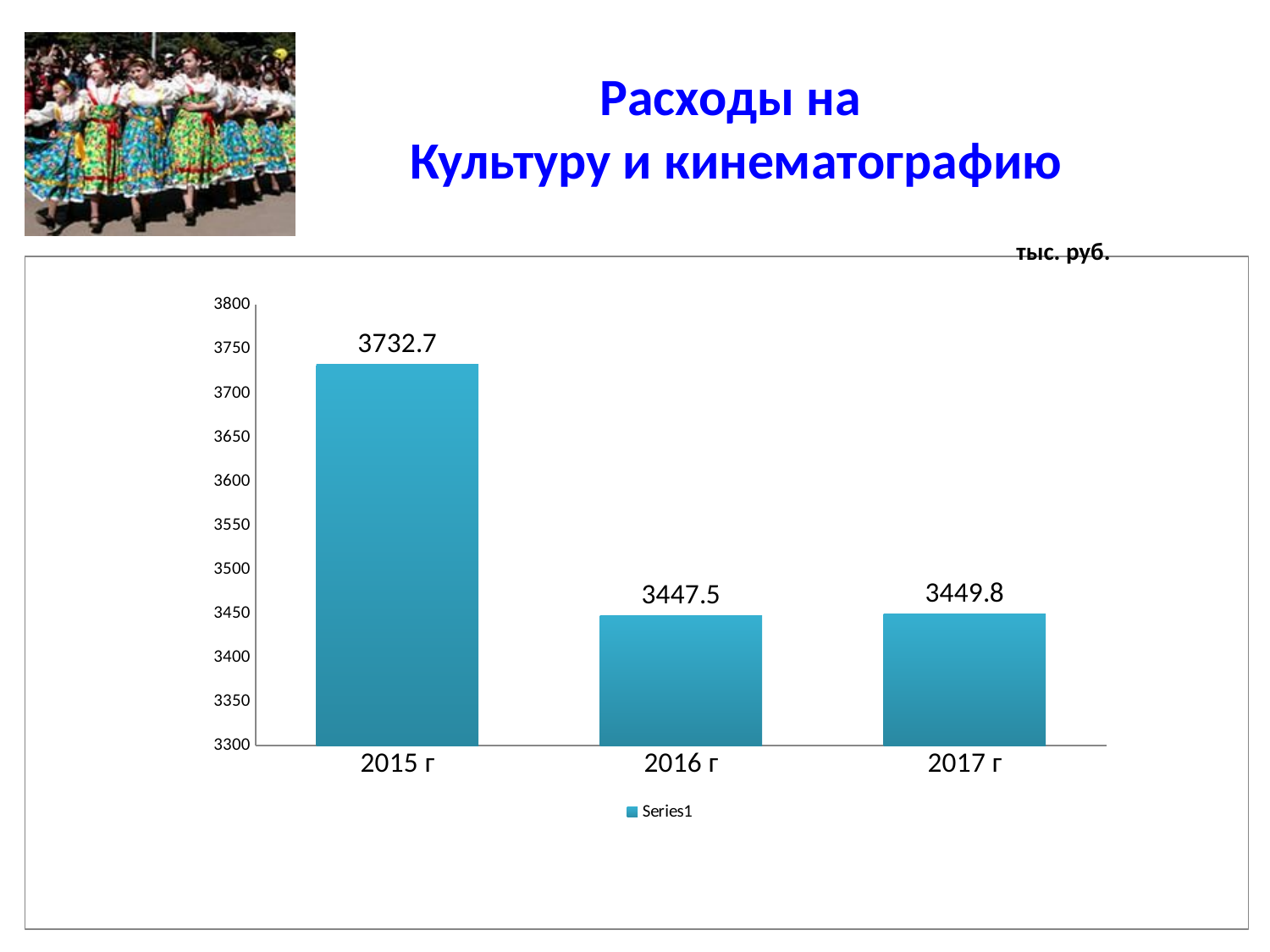
What kind of chart is shown on the slide? bar chart Which year has the lowest value? 2016 г What is the difference between the values for 2015 г and 2016 г? 285.2 What unit is indicated above the chart? тыс. руб. What is the value for 2016 г? 3447.5 How many years are shown on the x axis? 3 Is the value for 2015 г greater or less than 3700? greater Which year has the highest value? 2015 г What is the value for 2017 г? 3449.8 What is the value for 2015 г? 3732.7 Which is larger, the value for 2016 г or the value for 2017 г? 2017 г What is the difference between the values for 2017 г and 2016 г? 2.3